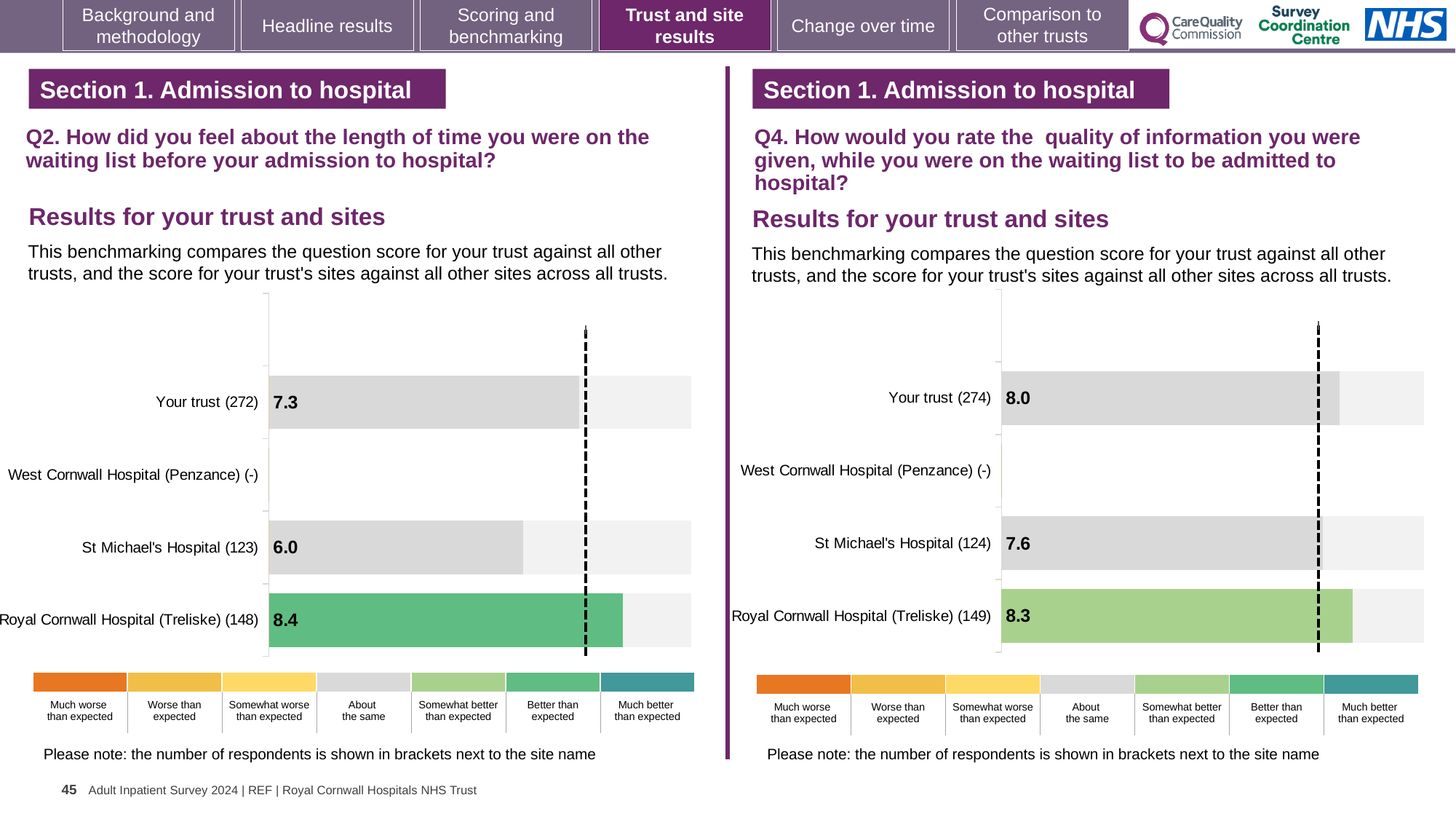
In the Q2 chart on the left, what is the difference between the scores for Royal Cornwall Hospital (Treliske) and St Michael's Hospital? 2.4 In the Q4 chart on the right, which site with a plotted score has the lowest score? St Michael's Hospital In the Q4 chart on the right, what is the score for St Michael's Hospital? 7.6 In the Q2 chart on the left, which site has the highest score? Royal Cornwall Hospital (Treliske) In the Q2 chart on the left, what is the score for Your trust? 7.3 What kind of chart is used for the Q4 results on the right? Bar chart In the Q2 chart on the left, what is the score for St Michael's Hospital? 6.0 In the Q4 chart on the right, what is the score for Royal Cornwall Hospital (Treliske)? 8.3 In the Q2 chart on the left, which benchmark category does the green colour of the Royal Cornwall Hospital (Treliske) bar correspond to in the legend? Better than expected Which is larger: the Your trust score in the Q2 chart on the left or the Your trust score in the Q4 chart on the right? Q4 chart (8.0) How many category labels are listed on the y axis of the Q2 chart on the left? 4 In the Q4 chart on the right, what is the difference between the scores for Your trust and St Michael's Hospital? 0.4